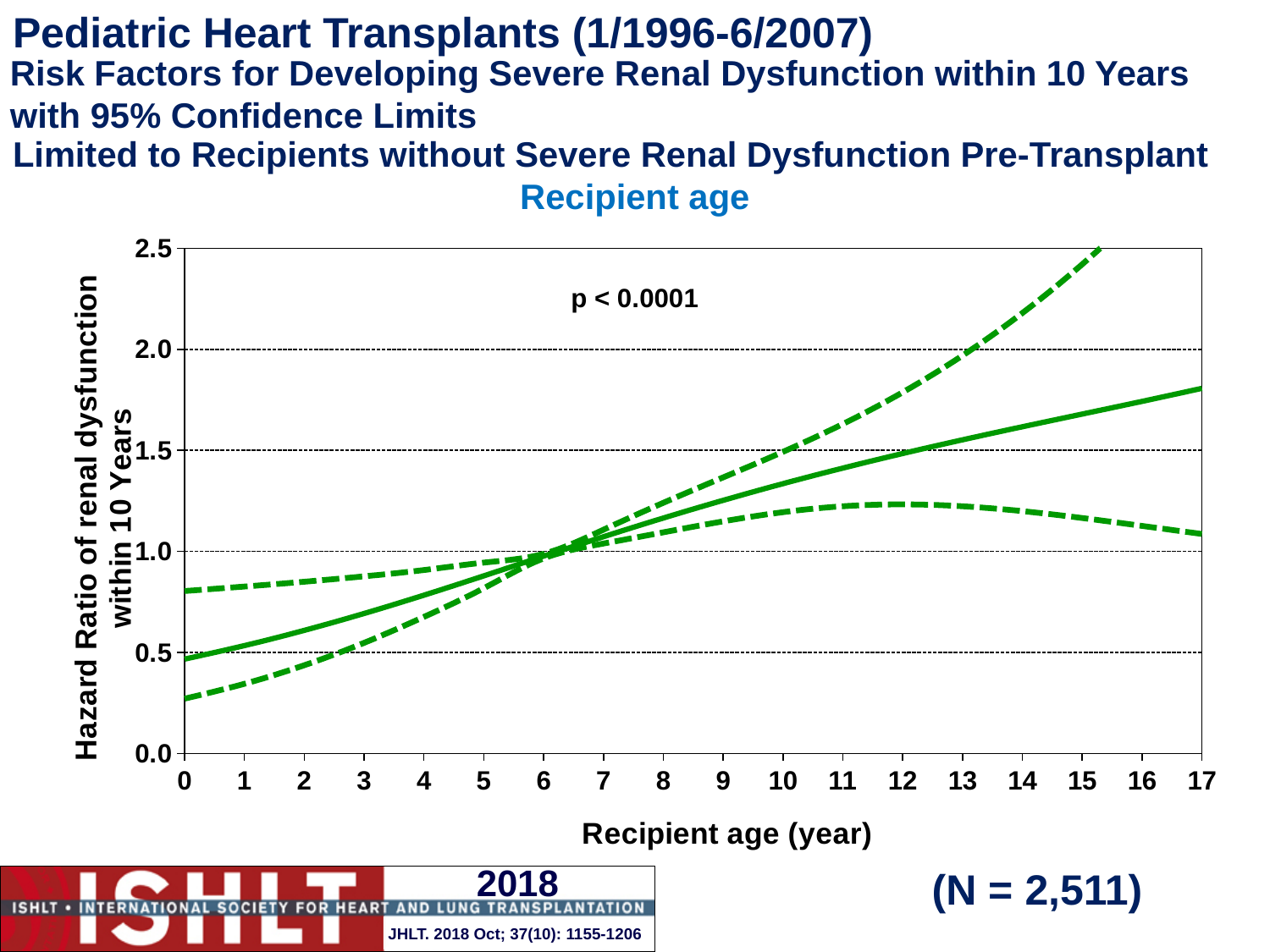
Is the upper dashed confidence limit at recipient age 0 greater or less than 1.0? less Is the lower dashed confidence limit at recipient age 0 greater or less than 0.5? less What kind of chart is shown on the slide? line chart What p-value is printed on the chart? p < 0.0001 Is the hazard ratio on the solid line at recipient age 0 greater or less than 1.0? less Does the solid hazard ratio line rise or fall as recipient age increases from 0 to 17 years? rise What is the highest value shown on the y axis of the chart? 2.5 How many lines are plotted on the chart? 3